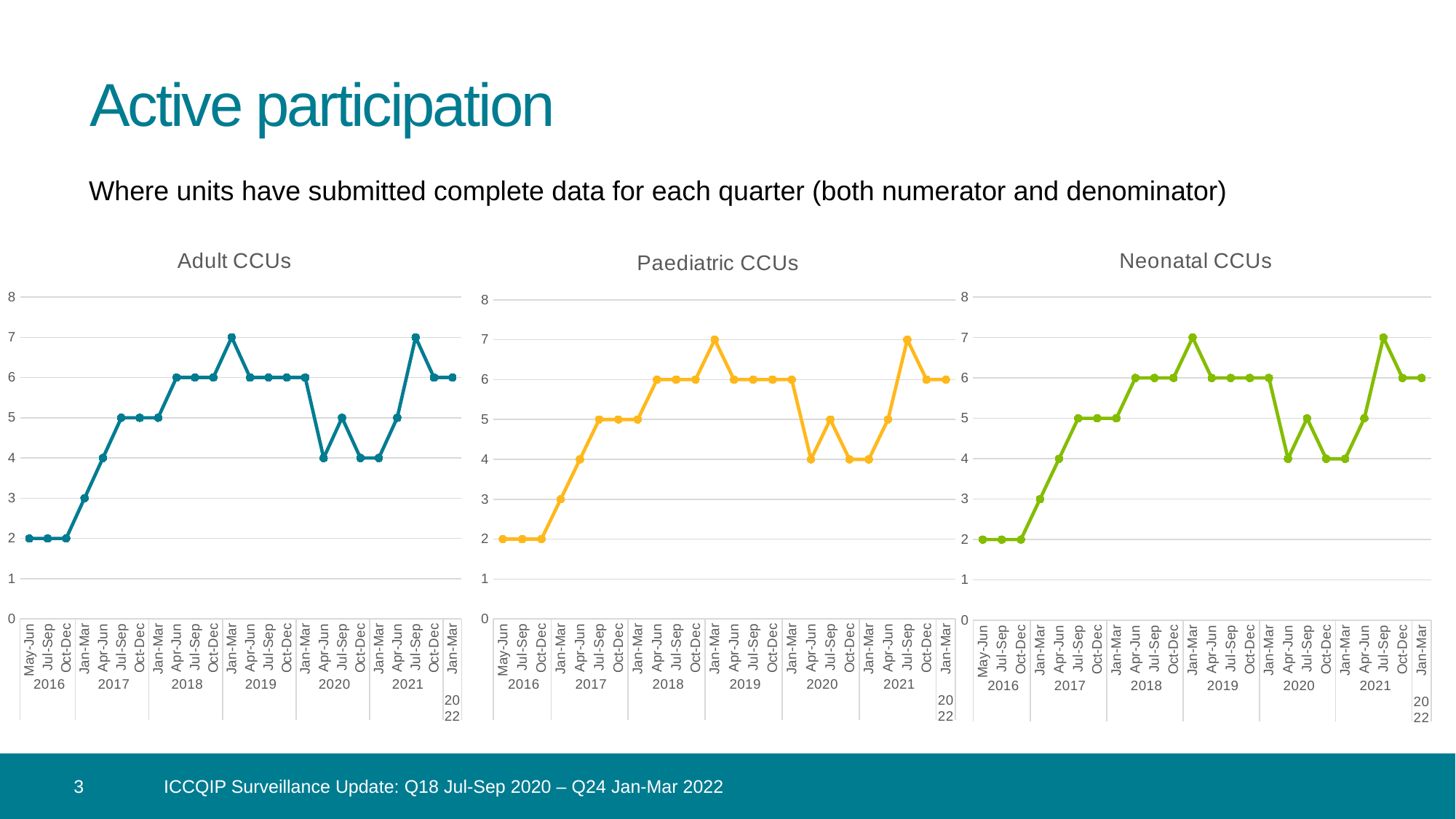
What kind of chart is the Adult CCUs chart? line chart In the Adult CCUs chart, what is the value for Jan-Mar 2019? 7 In the Paediatric CCUs chart, what is the value for May-Jun 2016? 2 In the Adult CCUs chart, what is the lowest value plotted? 2 In the Paediatric CCUs chart, is the value for Jan-Mar 2022 greater or less than 4? greater In the Neonatal CCUs chart, what is the value for Apr-Jun 2020? 4 In the Neonatal CCUs chart, what is the difference between the value for Jul-Sep 2021 and the value for Oct-Dec 2020? 3 In the Paediatric CCUs chart, what is the highest value plotted? 7 What colour is the line in the Paediatric CCUs chart? yellow/orange In the Adult CCUs chart, which is larger: the value for Jan-Mar 2020 or the value for Apr-Jun 2020? Jan-Mar 2020 In the Neonatal CCUs chart, do the values rise or fall from May-Jun 2016 to Jan-Mar 2019? rise How many charts are shown on the slide? 3